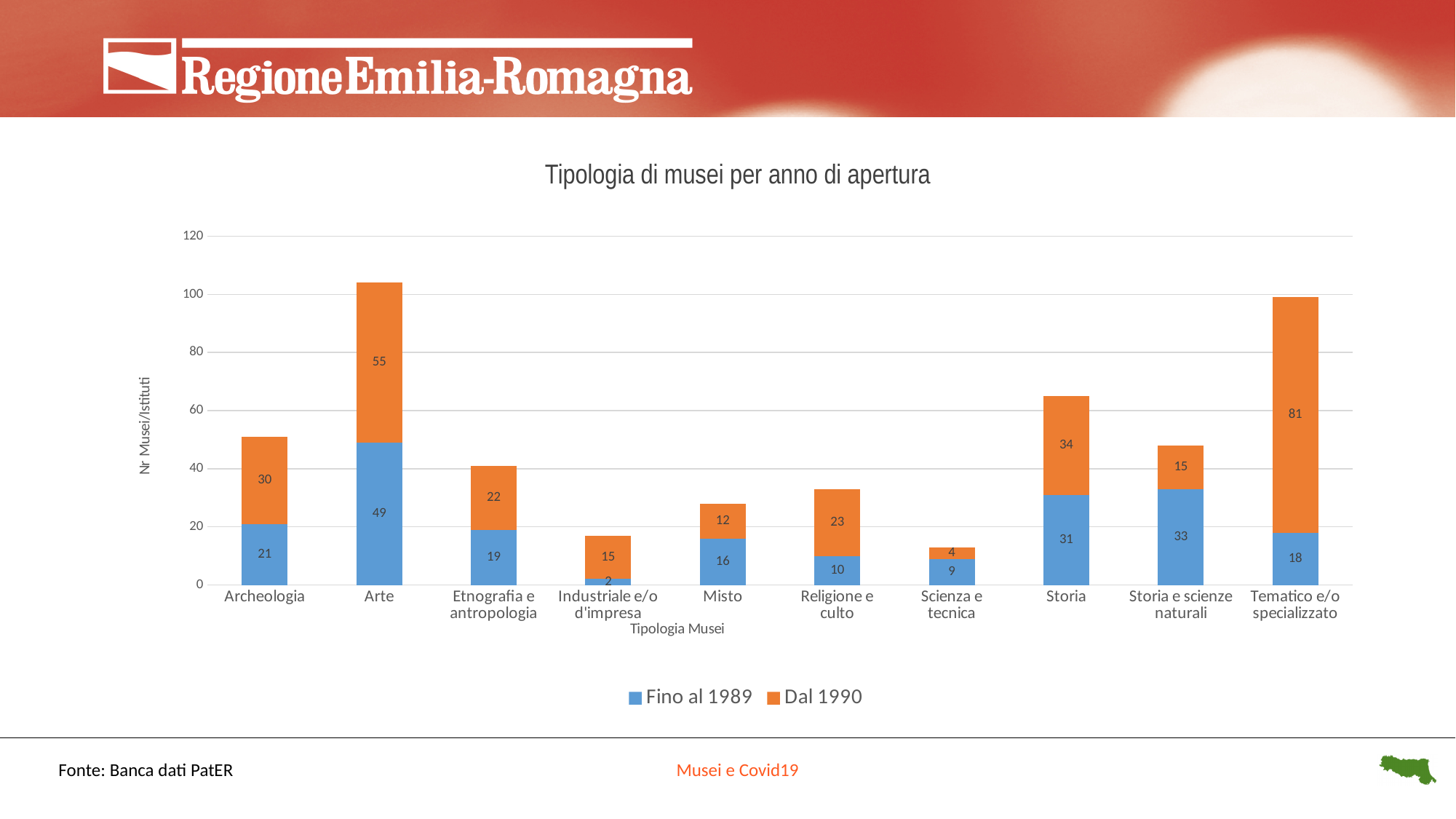
What kind of chart is shown on the slide? Stacked bar chart Which is larger for Misto: the Fino al 1989 value or the Dal 1990 value? Fino al 1989 What is the value for Tematico e/o specializzato in the Dal 1990 series? 81 How many categories are shown on the x axis? 10 What is the value for Arte in the Fino al 1989 series? 49 Which category has the lowest value in the Dal 1990 series? Scienza e tecnica What is the value for Industriale e/o d'impresa in the Fino al 1989 series? 2 How many series does the legend list? 2 What is the total of the stacked bar for Storia? 65 Which category has the highest value in the Dal 1990 series? Tematico e/o specializzato What is the difference between the Dal 1990 and Fino al 1989 values for Religione e culto? 13 What is the total of the stacked bar for Arte? 104